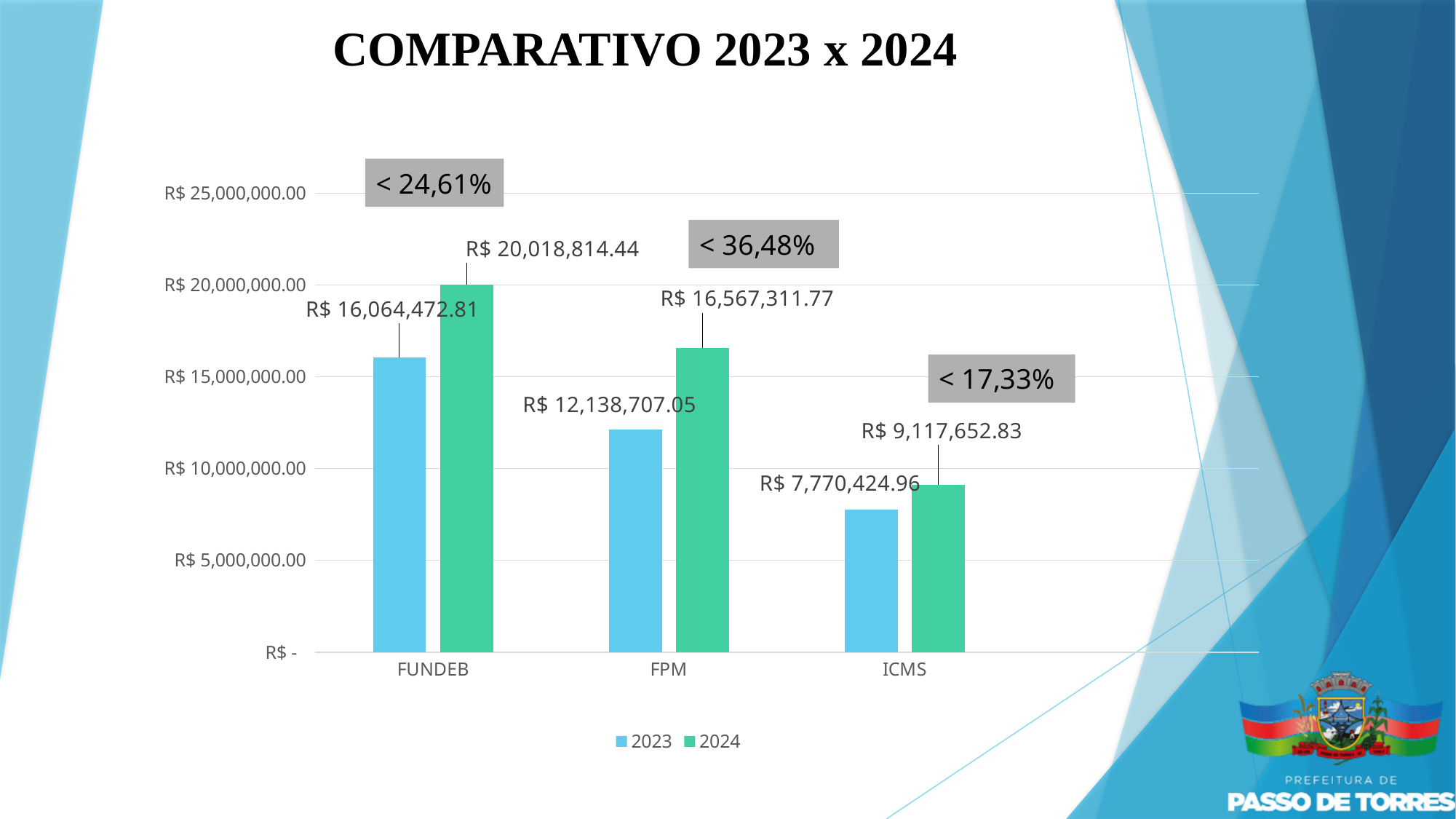
What is the value for FPM in the 2023 series? R$ 12,138,707.05 What is the value for FUNDEB in the 2024 series? R$ 20,018,814.44 Which category has the highest 2024 value? FUNDEB What is the difference between the 2024 and 2023 values for ICMS? R$ 1,347,227.87 How many series does the legend list? 2 What is the value for ICMS in the 2024 series? R$ 9,117,652.83 What is the difference between the 2024 and 2023 values for FPM? R$ 4,428,604.72 Which category has the lowest 2023 value? ICMS What is the value for FUNDEB in the 2023 series? R$ 16,064,472.81 What kind of chart is shown on the slide? Bar chart How many categories are shown on the x axis? 3 Which is larger: the 2023 value for FUNDEB or the 2024 value for FPM? 2024 value for FPM